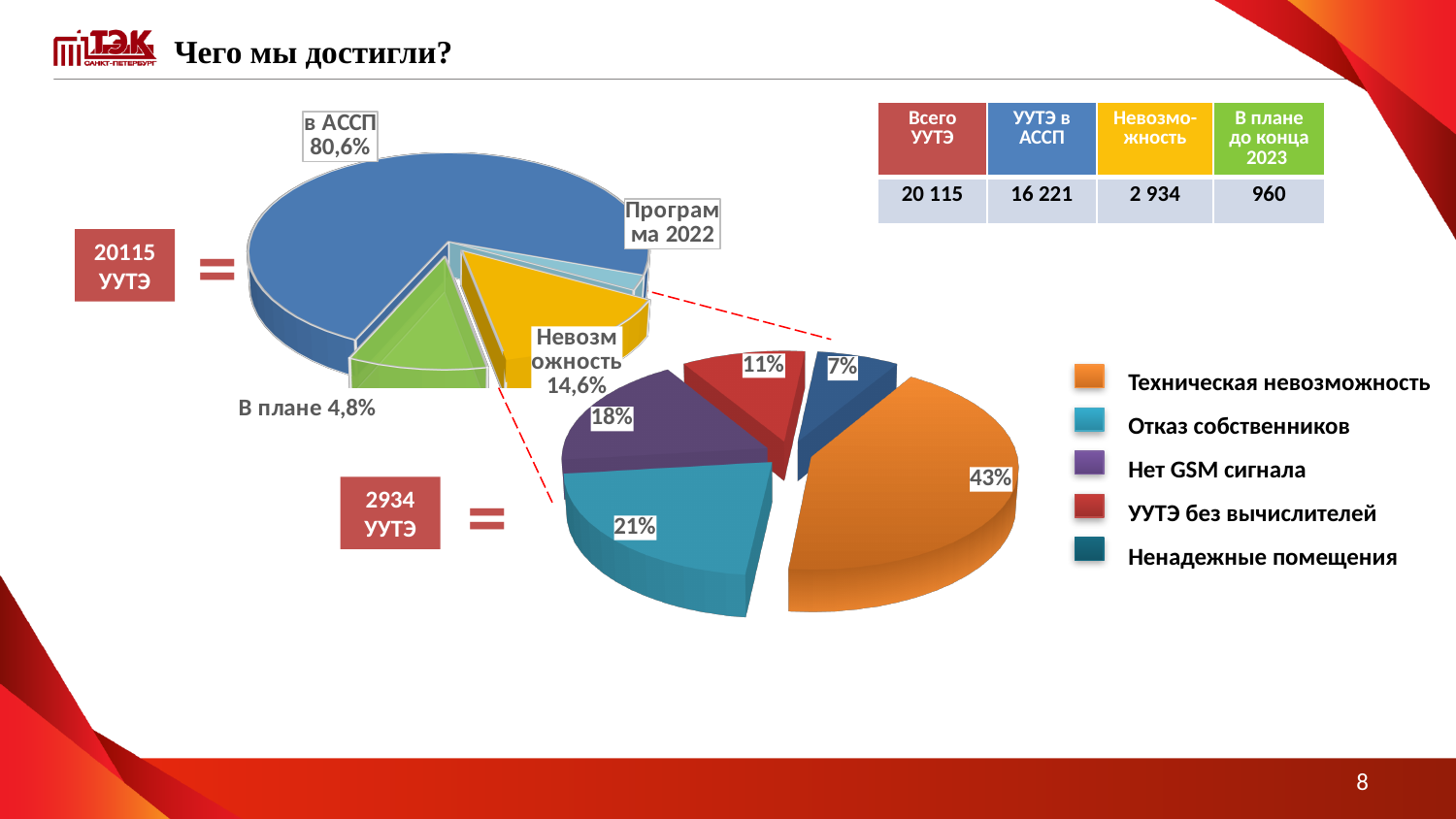
In the upper-left pie chart (20115 УУТЭ), what share is labelled for 'в АССП'? 80,6% In the lower pie chart (2934 УУТЭ), which is larger: 'Нет GSM сигнала' or 'УУТЭ без вычислителей'? Нет GSM сигнала In the lower pie chart (2934 УУТЭ), what percentage is shown for 'Техническая невозможность'? 43% In the lower pie chart (2934 УУТЭ), what is the difference in percentage points between 'Техническая невозможность' and 'Отказ собственников'? 22 In the upper-left pie chart (20115 УУТЭ), what share is labelled for 'Невозможность'? 14,6% How many categories does the legend of the lower pie chart (2934 УУТЭ) list? 5 In the lower pie chart (2934 УУТЭ), what percentage is shown for 'Нет GSM сигнала'? 18% In the upper-left pie chart (20115 УУТЭ), what share is labelled for 'В плане'? 4,8% In the upper-left pie chart (20115 УУТЭ), which labelled slice is the largest? в АССП What kind of charts are shown on the slide? Pie charts In the lower pie chart (2934 УУТЭ), which category has the smallest slice? Ненадежные помещения In the lower pie chart (2934 УУТЭ), what percentage is shown for 'Отказ собственников'? 21%